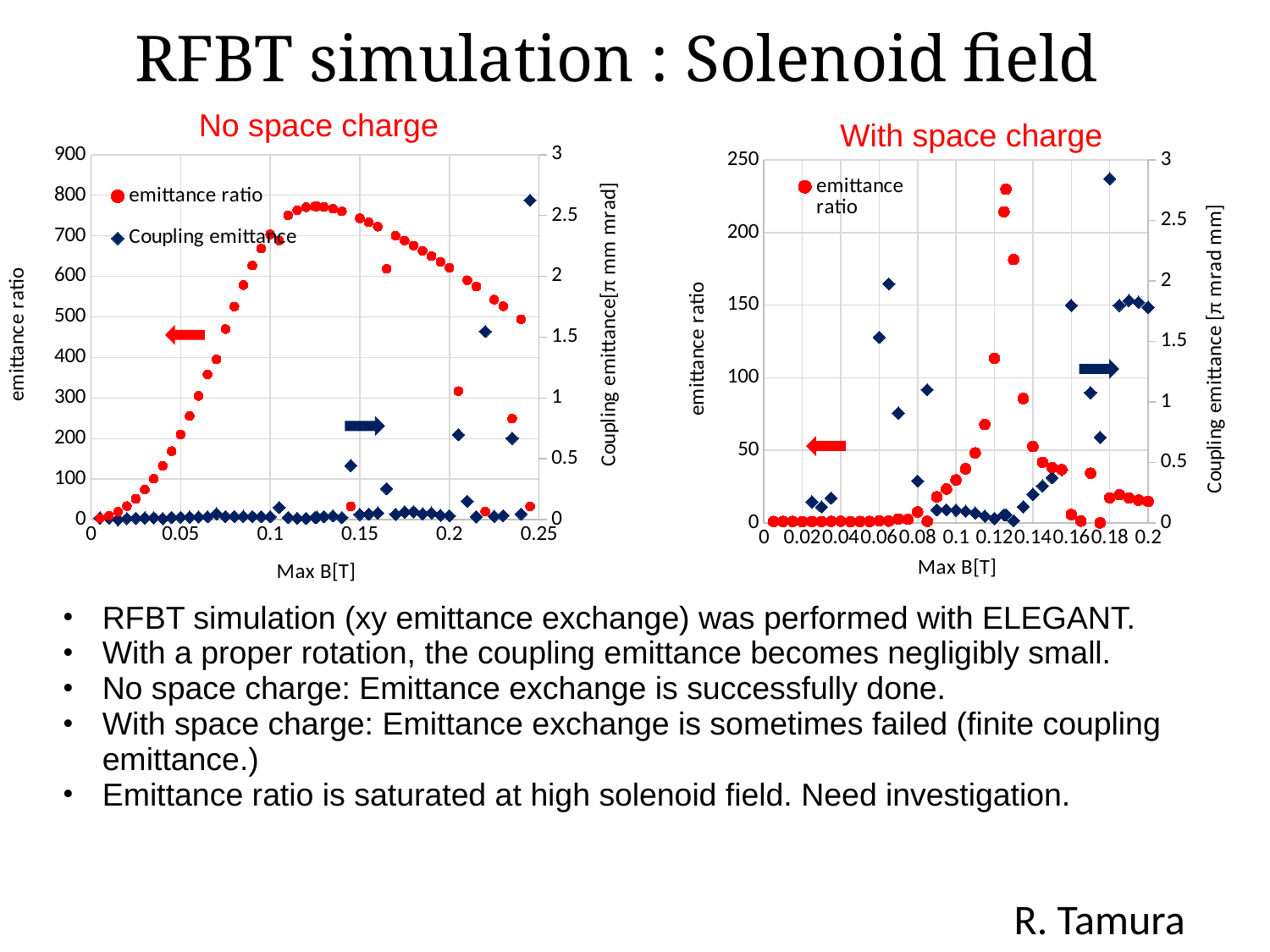
In the "With space charge" chart, is the highest coupling emittance value greater or less than 2.5? greater What kind of chart is the "No space charge" chart? scatter chart What is the x-axis title of the "With space charge" chart? Max B[T] In the "No space charge" chart, is the peak emittance ratio (around 0.125 T) greater or less than 700? greater In the "No space charge" chart, which series is plotted with red circles? emittance ratio In the "No space charge" chart, is the emittance ratio at 0.05 T greater or less than 300? less How many series does the legend of the "With space charge" chart list? 1 In the "No space charge" chart, does the emittance ratio rise or fall as Max B increases from 0 to 0.1 T? rise In the "With space charge" chart, does the emittance ratio rise or fall as Max B increases from 0.12 T to 0.2 T? fall